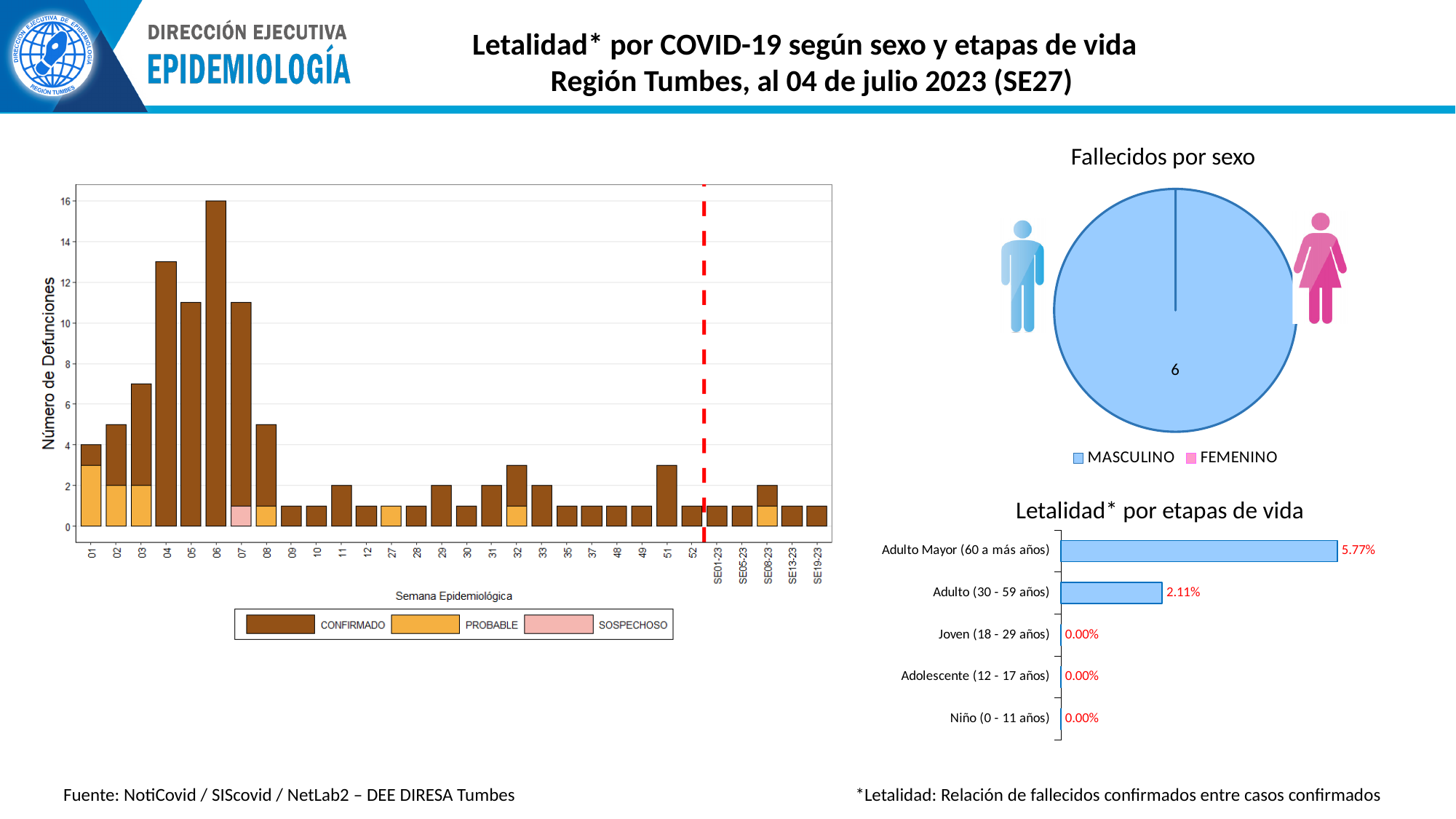
In the 'Letalidad* por etapas de vida' chart, what is the value for Joven (18 - 29 años)? 0.00% In the 'Número de Defunciones' bar chart on the left, which epidemiological week has the highest total? 06 In the 'Número de Defunciones' bar chart on the left, what is the total for week 06? 16 In the 'Letalidad* por etapas de vida' chart, what is the difference between Adulto Mayor (60 a más años) and Adulto (30 - 59 años)? 3.66% In the 'Letalidad* por etapas de vida' chart, what is the value for Adulto Mayor (60 a más años)? 5.77% How many series does the legend of the 'Fallecidos por sexo' pie chart list? 2 In the 'Letalidad* por etapas de vida' chart, how many age groups are shown? 5 In the 'Letalidad* por etapas de vida' chart, which age group has the highest value? Adulto Mayor (60 a más años) In the 'Número de Defunciones' bar chart on the left, is the total for week 04 greater or less than 12? greater In the 'Fallecidos por sexo' pie chart, what value is shown for MASCULINO? 6 In the 'Letalidad* por etapas de vida' chart, what is the value for Adulto (30 - 59 años)? 2.11% How many series does the legend of the 'Número de Defunciones' bar chart on the left list? 3